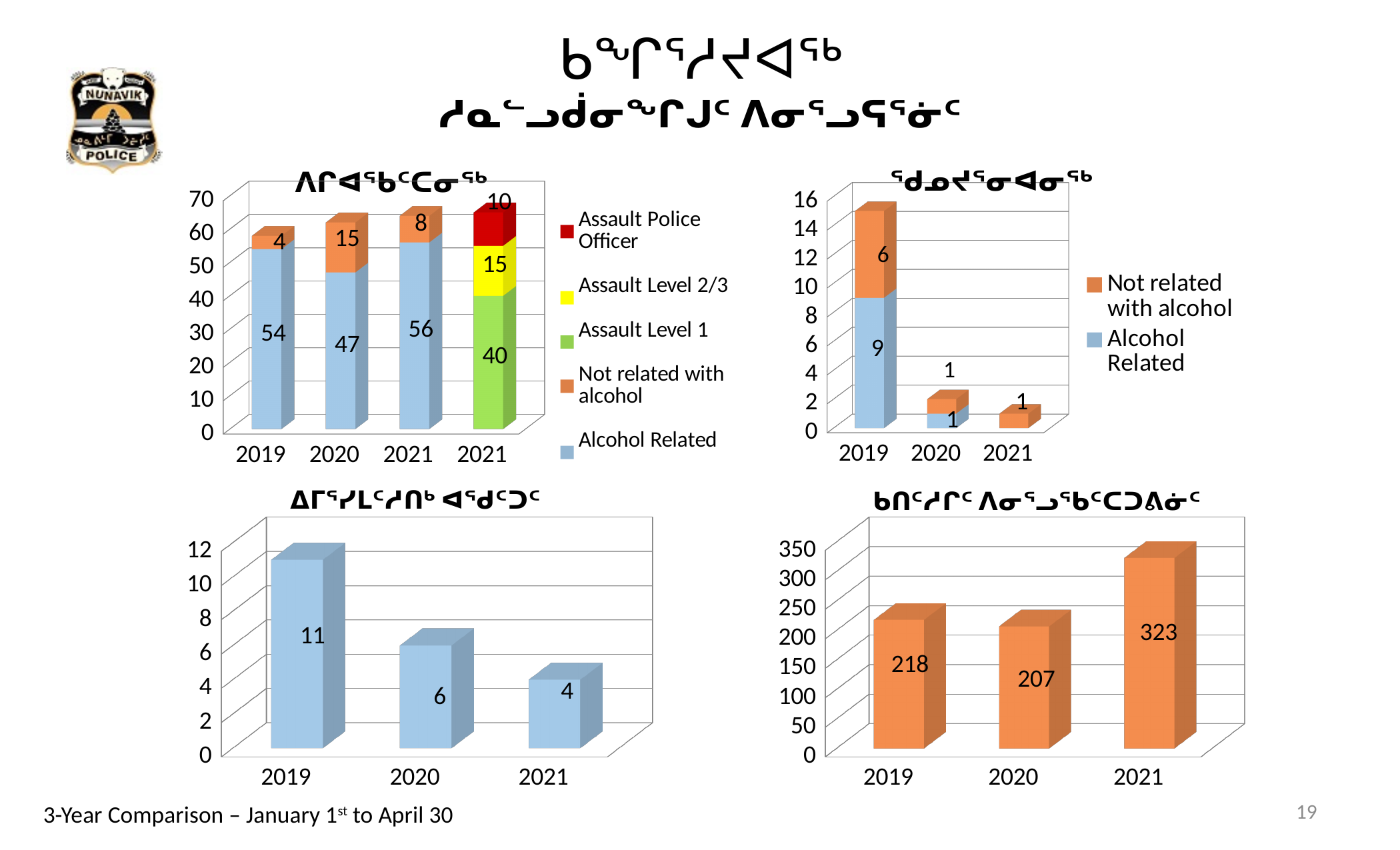
In the bottom-right chart, what is the value for 2021? 323 In the bottom-left chart, what is the value for 2019? 11 In the bottom-left chart, how many years are shown on the x axis? 3 In the top-left chart, what is the Alcohol Related value for 2020? 47 In the bottom-left chart, do the values rise or fall from 2019 to 2021? fall In the top-left chart, what is the Assault Level 1 value in the rightmost 2021 bar? 40 In the bottom-right chart, what is the difference between the values for 2021 and 2019? 105 How many series does the legend of the top-left chart list? 5 In the top-left chart, what is the total of the stacked bar for 2019? 58 In the top-right chart, what is the Alcohol Related value for 2019? 9 In the bottom-right chart, which year has the lowest value? 2020 What kind of chart is the bottom-right chart? bar chart